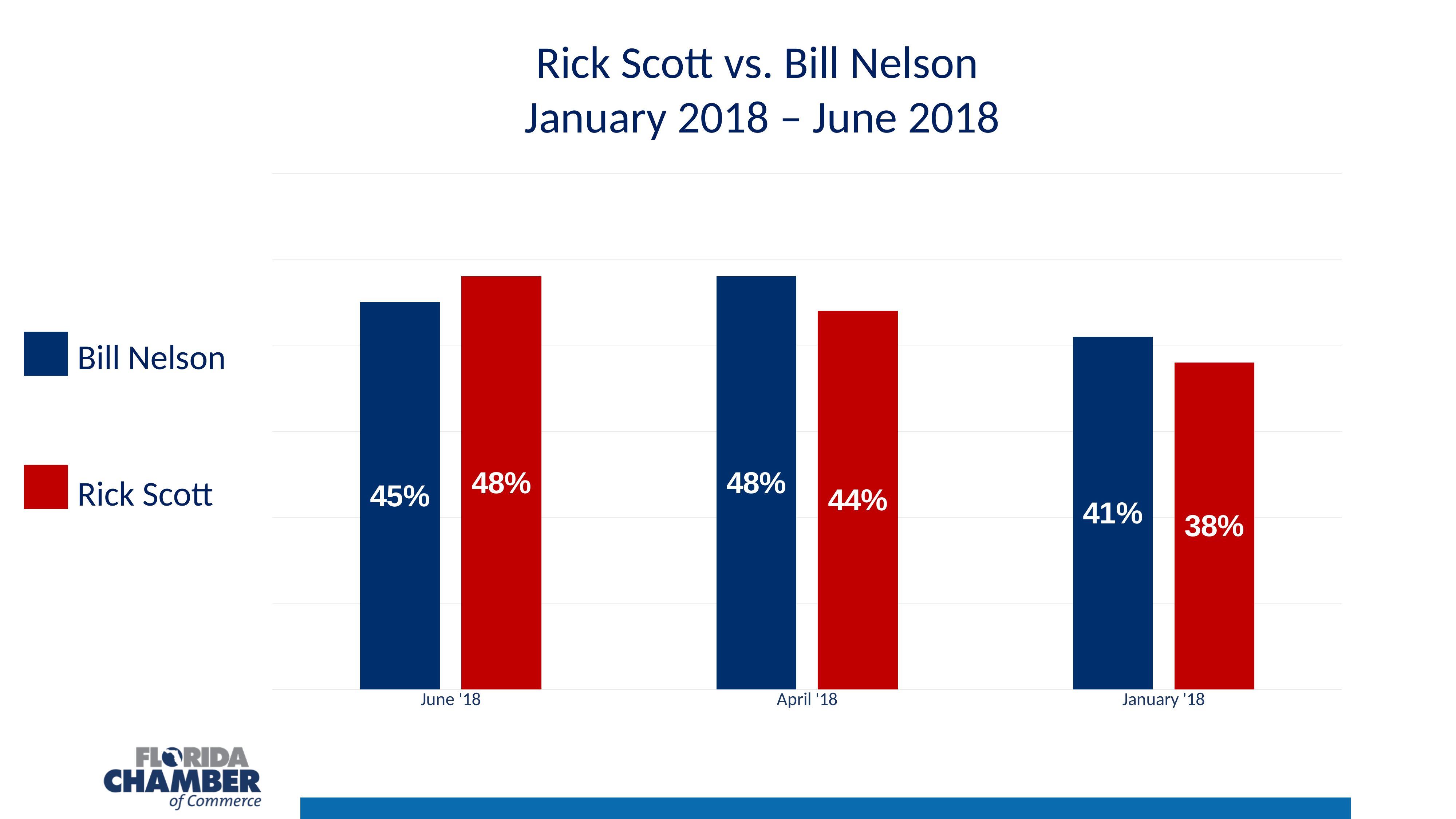
What is the difference between Bill Nelson and Rick Scott in April '18? 4% Who has the larger value in June '18, Bill Nelson or Rick Scott? Rick Scott How many time periods are shown on the x axis? 3 What is the value for Bill Nelson in June '18? 45% What is the value for Rick Scott in January '18? 38% What is the value for Rick Scott in June '18? 48% What is the value for Rick Scott in April '18? 44% What is the value for Bill Nelson in January '18? 41% How many series does the legend list? 2 In which period is Bill Nelson's value highest? April '18 In which period is Rick Scott's value lowest? January '18 What kind of chart is shown on the slide? Bar chart